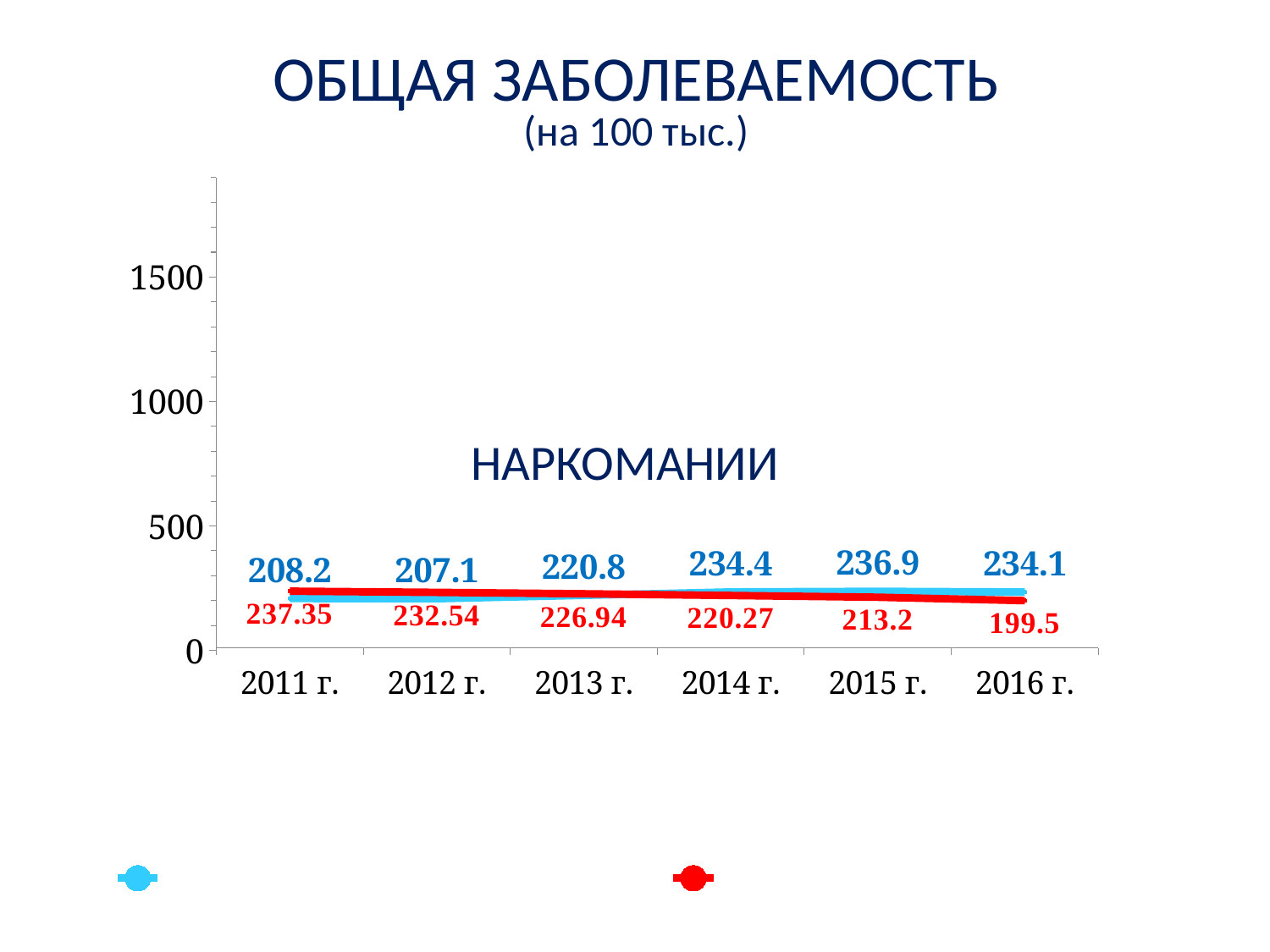
What kind of chart is shown on the slide? line chart What is the difference between the red series value and the blue series value in 2011 г.? 29.15 Which series has the larger value in 2016 г., the blue or the red? blue How many series does the legend list? 2 What is the value of the red series for 2016 г.? 199.5 Is the value of the blue series for 2014 г. greater or less than 500? less What is the value of the blue series for 2011 г.? 208.2 In which year does the red series have its lowest value? 2016 г. How many years are shown on the x axis? 6 Does the red series rise or fall from 2011 г. to 2016 г.? fall What is the value of the red series for 2013 г.? 226.94 In which year does the blue series reach its highest value? 2015 г.